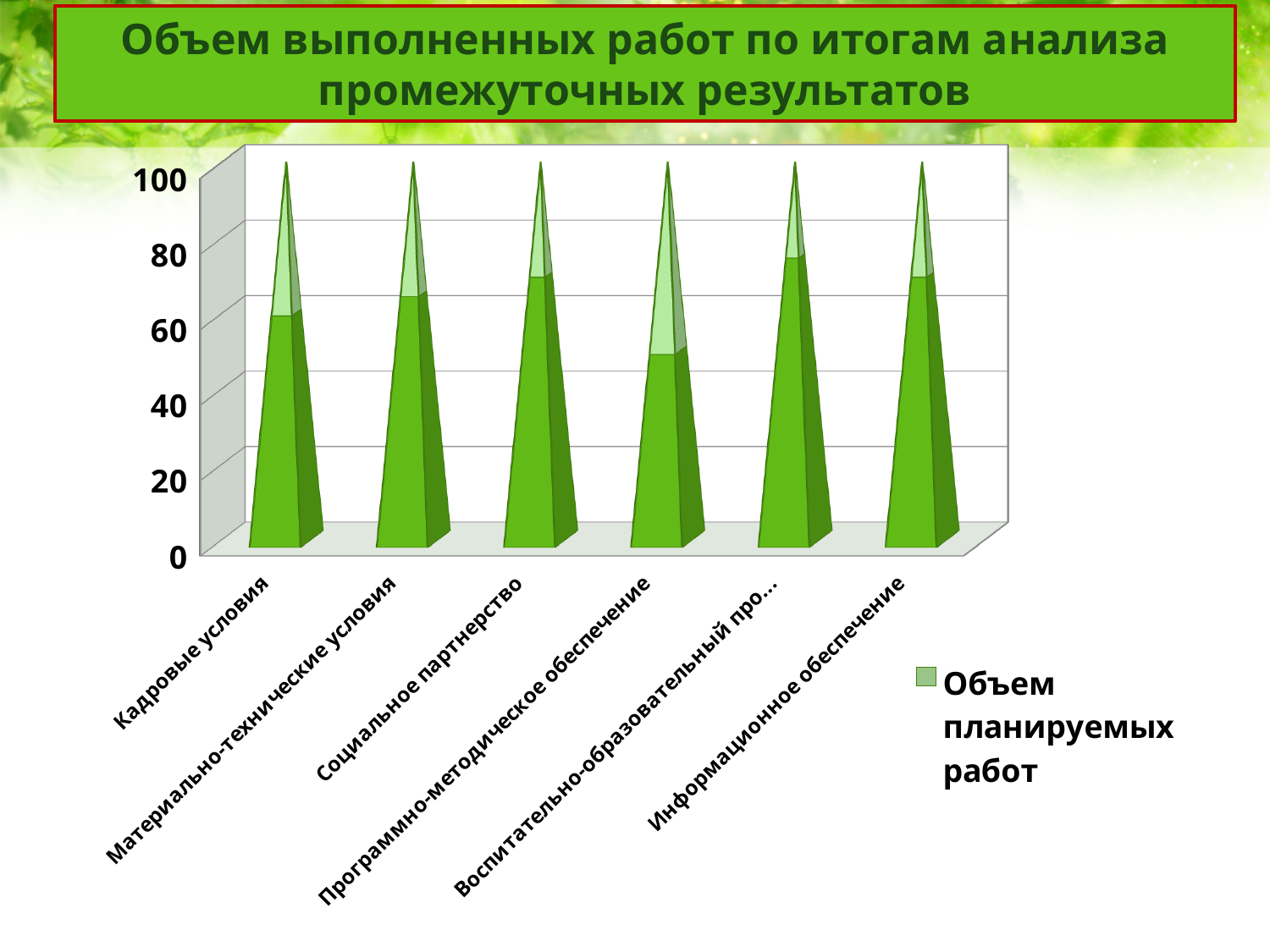
What kind of chart is shown on the slide? bar chart Which category has the lowest dark green (completed) value? Программно-методическое обеспечение Which has the larger dark green value: Кадровые условия or Воспитательно-образовательный про...? Воспитательно-образовательный про... What is the title of the slide containing the chart? Объем выполненных работ по итогам анализа промежуточных результатов Is the dark green value for Социальное партнерство greater or less than 60? greater Is the dark green value for Программно-методическое обеспечение greater or less than 60? less Which has the larger dark green value: Программно-методическое обеспечение or Социальное партнерство? Социальное партнерство Is the dark green value for Воспитательно-образовательный про... greater or less than 60? greater How many categories are shown along the x axis of the chart? 6 What is the legend entry shown on the chart? Объем планируемых работ How many series does the chart legend list? 1